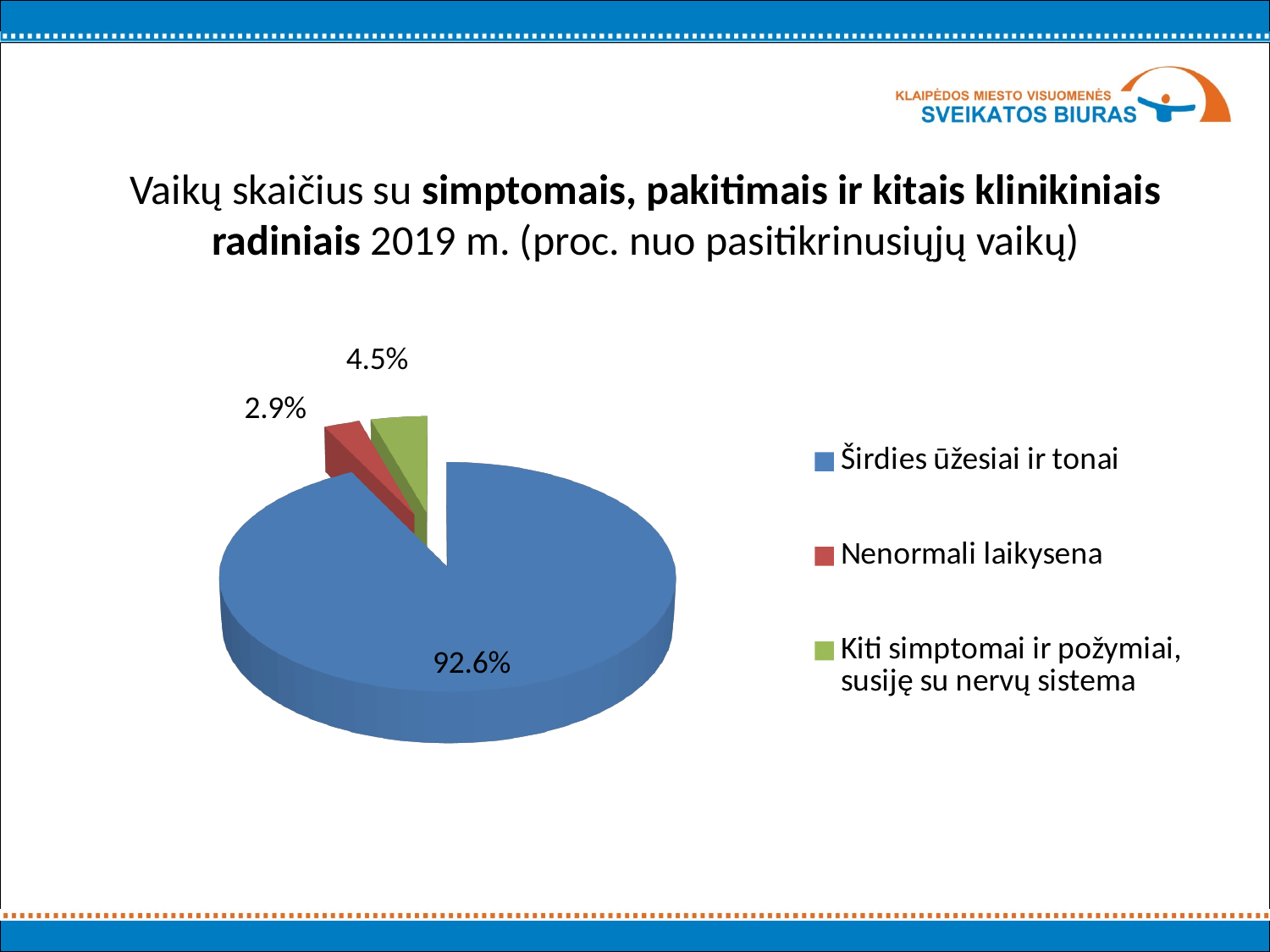
How many slices does the pie chart have? 3 Which category has the smallest share of the pie? Nenormali laikysena What is the value for Nenormali laikysena? 2.9% Which category has the largest share of the pie? Širdies ūžesiai ir tonai What is the difference between the values for Kiti simptomai ir požymiai, susiję su nervų sistema and Nenormali laikysena? 1.6% What kind of chart is shown on the slide? pie chart What is the value for Širdies ūžesiai ir tonai? 92.6% Which is larger, the value for Nenormali laikysena or the value for Kiti simptomai ir požymiai, susiję su nervų sistema? Kiti simptomai ir požymiai, susiję su nervų sistema What is the difference between the values for Širdies ūžesiai ir tonai and Kiti simptomai ir požymiai, susiję su nervų sistema? 88.1% How many entries does the legend list? 3 What colour is the slice for Nenormali laikysena? red What is the value for Kiti simptomai ir požymiai, susiję su nervų sistema? 4.5%